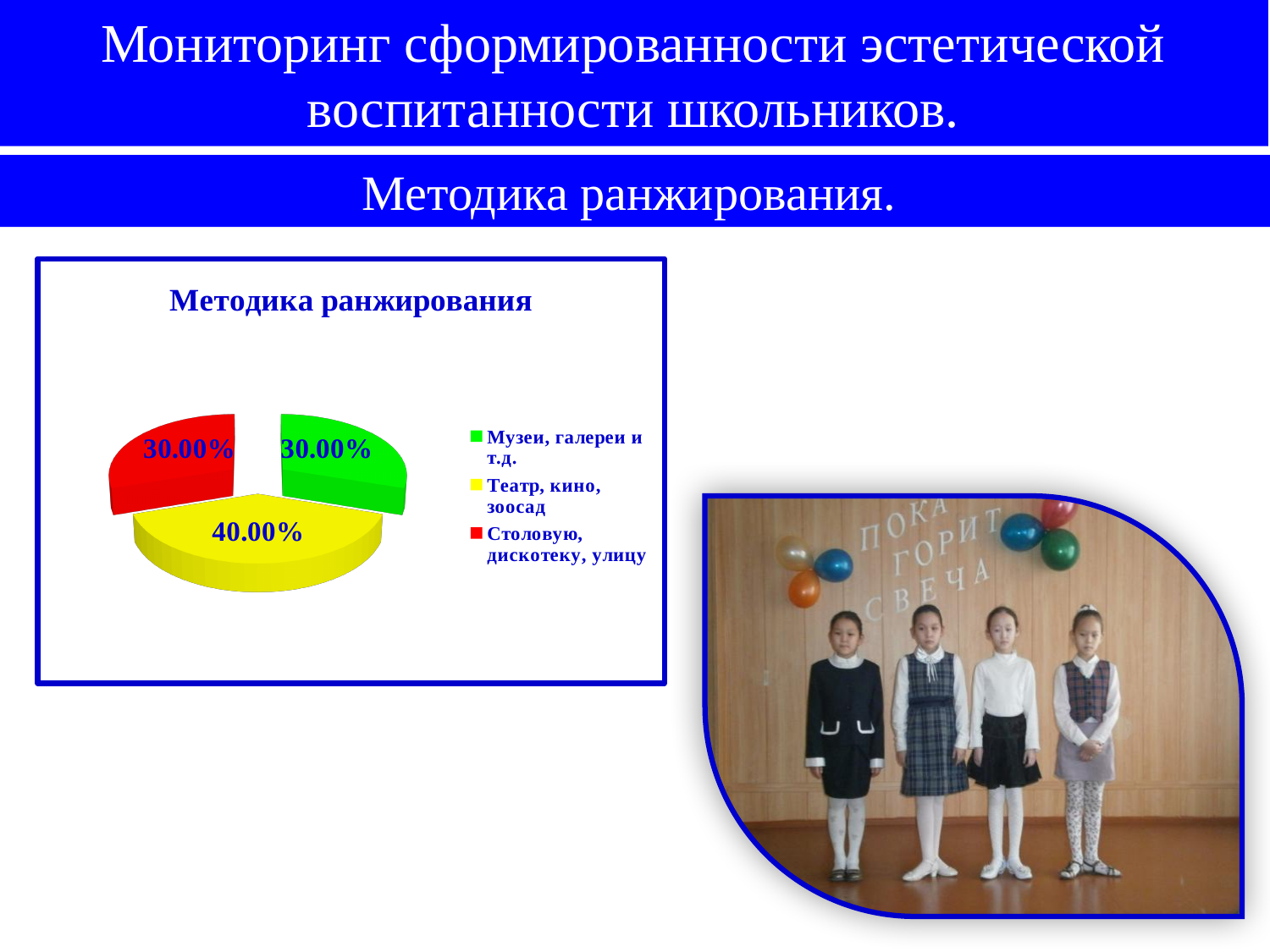
Is the share for "Театр, кино, зоосад" greater or less than the share for "Столовую, дискотеку, улицу"? greater How many entries does the chart legend list? 3 Which colour represents "Столовую, дискотеку, улицу" in the pie chart? red What is the title of the chart? Методика ранжирования What share of the pie is labelled "Музеи, галереи и т.д."? 30.00% How many slices does the pie chart have? 3 Which category has the largest share of the pie? Театр, кино, зоосад What type of chart is shown on the slide? pie chart What share of the pie is labelled "Театр, кино, зоосад"? 40.00% What share of the pie is labelled "Столовую, дискотеку, улицу"? 30.00% What is the difference between the share for "Театр, кино, зоосад" and the share for "Столовую, дискотеку, улицу"? 10.00% Which is larger: the share for "Театр, кино, зоосад" or the share for "Музеи, галереи и т.д."? Театр, кино, зоосад